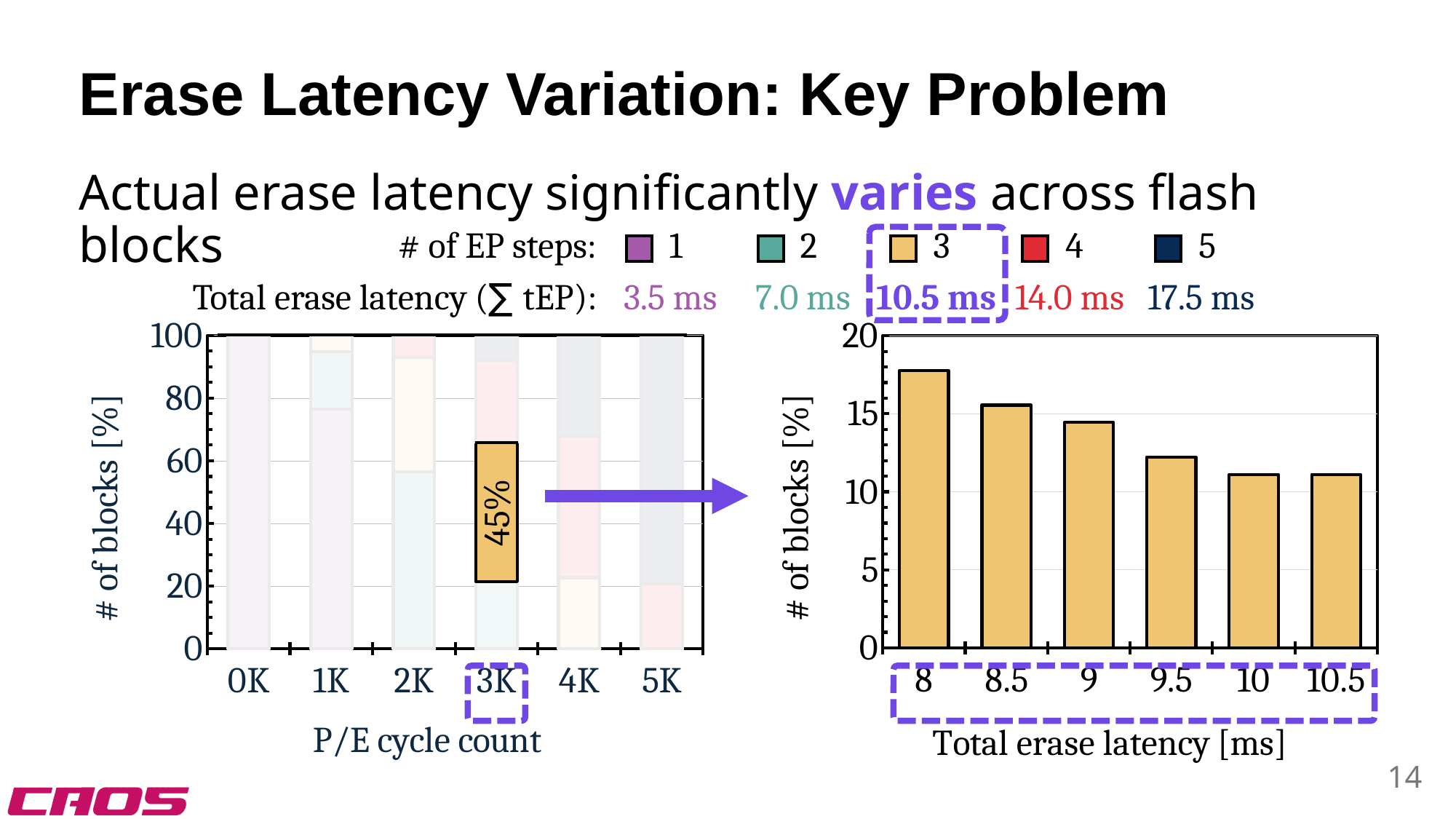
In the right chart (Total erase latency), do the values generally rise or fall as total erase latency increases from 8 to 10.5 ms? fall In the right chart (Total erase latency), is the value for 9.5 ms greater or less than 15? less How many P/E cycle count categories are shown on the x axis of the left chart? 6 In the right chart (Total erase latency), is the value for 8 ms greater or less than 15? greater How many series (numbers of EP steps) does the legend of the left chart list? 5 In the right chart (Total erase latency), is the value for 10 ms greater or less than 10? greater What is the x-axis title of the right chart? Total erase latency [ms] What kind of chart is the left chart with P/E cycle count on the x axis? Stacked bar chart In the right chart (Total erase latency), which total erase latency has the highest percentage of blocks? 8 In the right chart (Total erase latency), which has a larger percentage of blocks, 8.5 ms or 10 ms? 8.5 ms According to the legend, what is the total erase latency for 3 EP steps? 10.5 ms In the left chart (P/E cycle count), what percentage of blocks at 3K P/E cycles require 3 EP steps? 45%